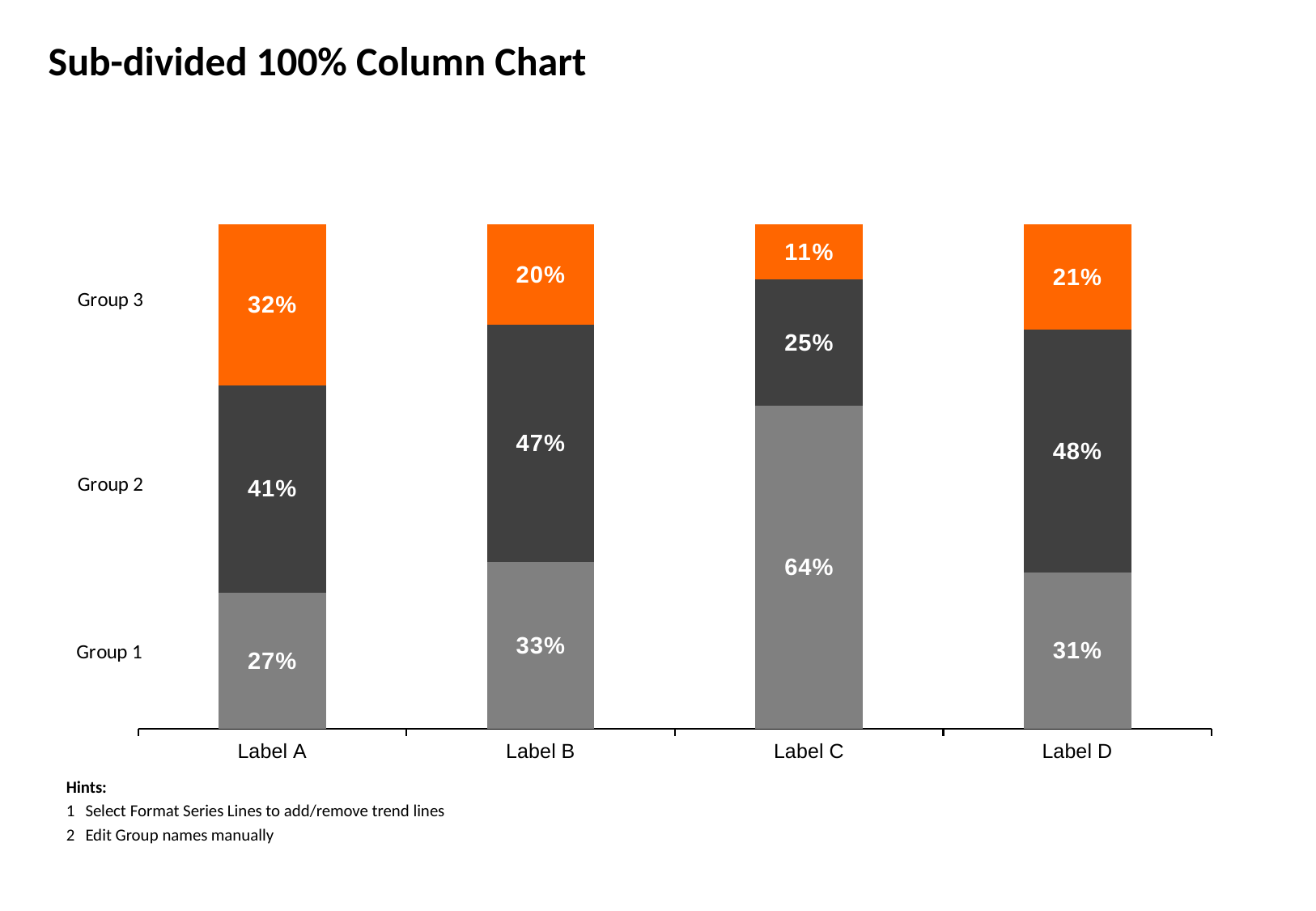
What is the title of the slide? Sub-divided 100% Column Chart What is the difference between the Group 2 values for Label B and Label A? 6% What is the value for Group 2 in Label D? 48% How many groups (series) are shown in the chart? 3 What kind of chart is shown on the slide? Stacked bar chart What is the total of the stacked bar for Label B? 100% What is the value for Group 3 in Label A? 32% Which label has the highest value for Group 1? Label C What is the value for Group 1 in Label C? 64% Which is larger: the Group 3 value for Label B or for Label D? Label D Which label has the lowest value for Group 3? Label C How many labels (categories) are shown on the x axis? 4